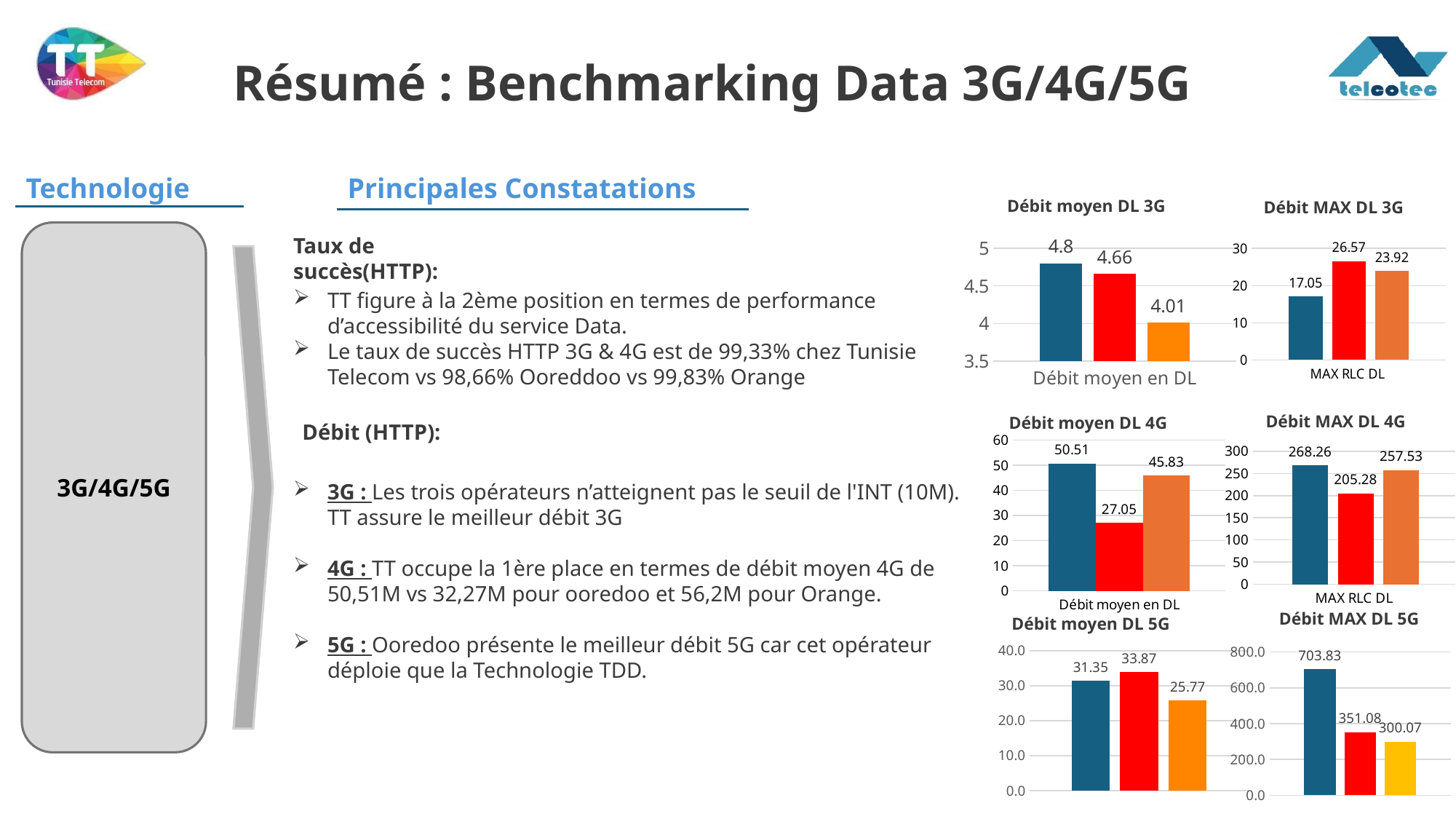
In the 'Débit MAX DL 4G' chart, what is the value of the first (blue) bar? 268.26 In the 'Débit MAX DL 5G' chart, what is the value of the first (blue) bar? 703.83 In the 'Débit moyen DL 3G' chart, what is the value of the third (orange) bar? 4.01 In the 'Débit moyen DL 5G' chart, what is the value of the red bar? 33.87 How many charts are shown on the slide, and what type are they? 6 bar charts In the 'Débit moyen DL 4G' chart, which bar has the lowest value? the second (red) bar, 27.05 In the 'Débit moyen DL 3G' chart, what is the value of the first (blue) bar? 4.8 In the 'Débit MAX DL 3G' chart, what is the difference between the red bar and the blue bar? 9.52 In the 'Débit MAX DL 4G' chart, which is larger, the blue bar or the orange bar? the blue bar (268.26) In the 'Débit MAX DL 3G' chart, which bar has the highest value? the second (red) bar, 26.57 In the 'Débit moyen DL 4G' chart, what is the value of the red bar? 27.05 In the 'Débit MAX DL 5G' chart, what is the difference between the blue bar and the red bar? 352.75